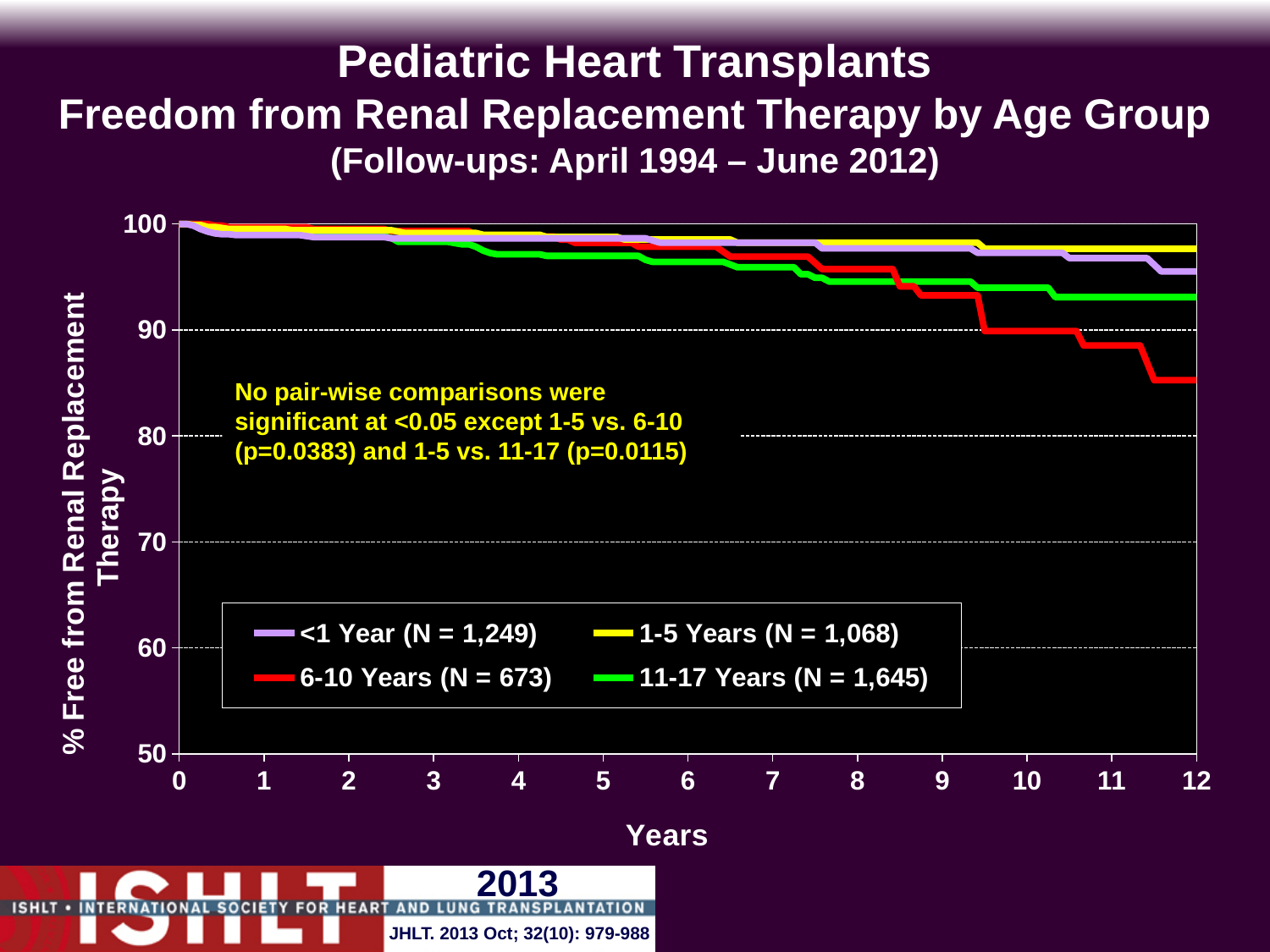
What kind of chart is shown on the slide? Line chart Which colour represents the 1-5 Years group? Yellow What is the N for the 11-17 Years group shown in the legend? 1,645 At 12 years, which group has the higher value: 6-10 Years or 11-17 Years? 11-17 Years Is the value for the <1 Year group at 12 years greater or less than 90? greater Which age group has the highest freedom from renal replacement therapy at 12 years? 1-5 Years Do the values for the 6-10 Years group rise or fall as years increase? Fall Is the value for the 6-10 Years group at 12 years greater or less than 90? less How many series does the legend list? 4 Is the value for the 11-17 Years group at 12 years greater or less than 90? greater Which age group has the lowest freedom from renal replacement therapy at 12 years? 6-10 Years What is the highest value shown on the y axis? 100